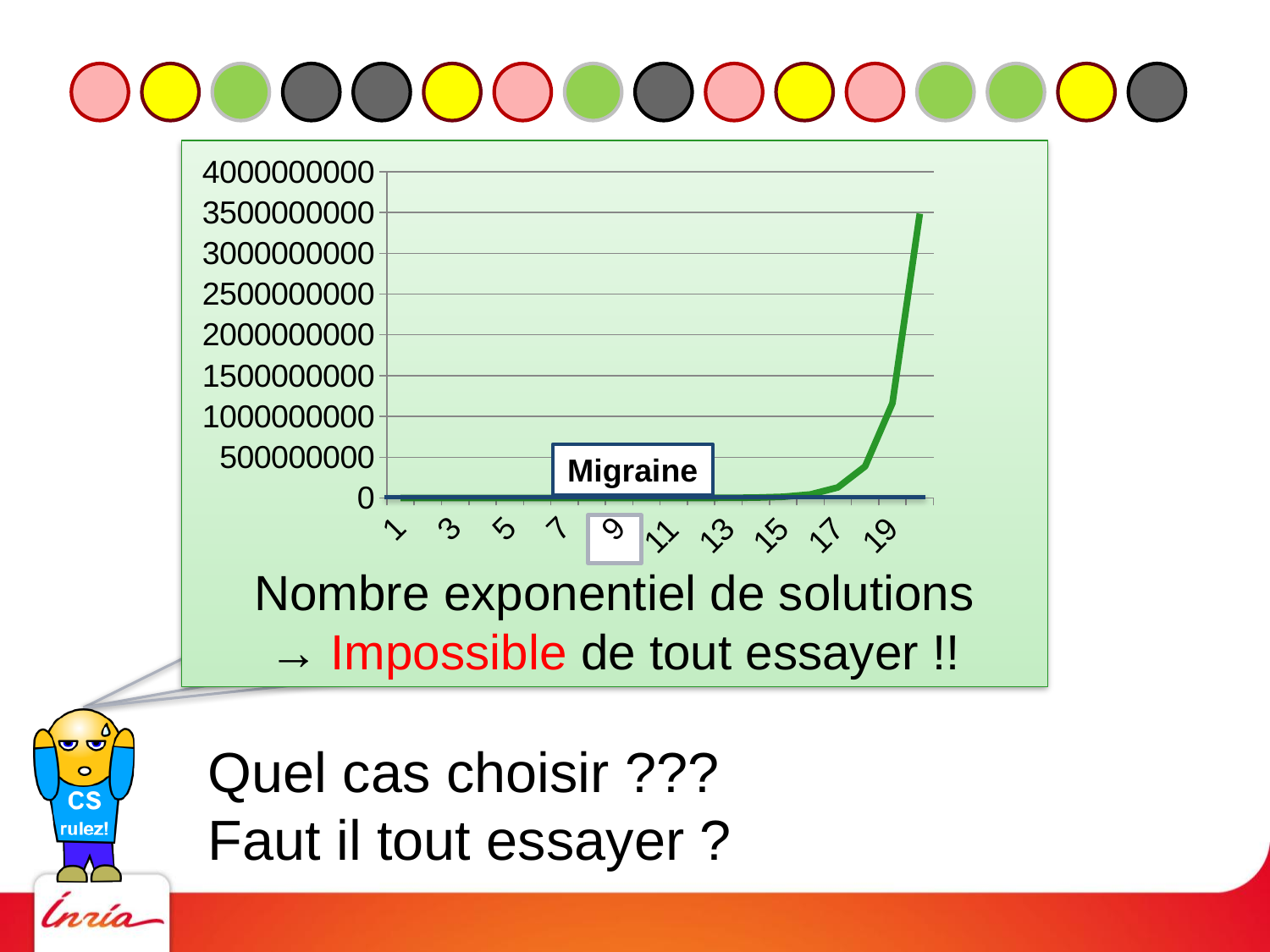
Do the values on the chart rise or fall as the x axis increases? rise Is the value at x = 15 greater or less than 500000000? less Is the highest value reached by the line greater or less than 4000000000? less Which of the two values is larger: the value at x = 19 or the value at x = 11? x = 19 Is the highest value reached by the line greater or less than 3000000000? greater How many labels are printed along the chart's x axis? 10 What kind of chart is shown on the slide? line chart What is the highest value shown on the chart's y axis? 4000000000 What is the lowest value shown on the chart's y axis? 0 Where along the x axis does the line reach its highest value: at the left end or the right end? right end